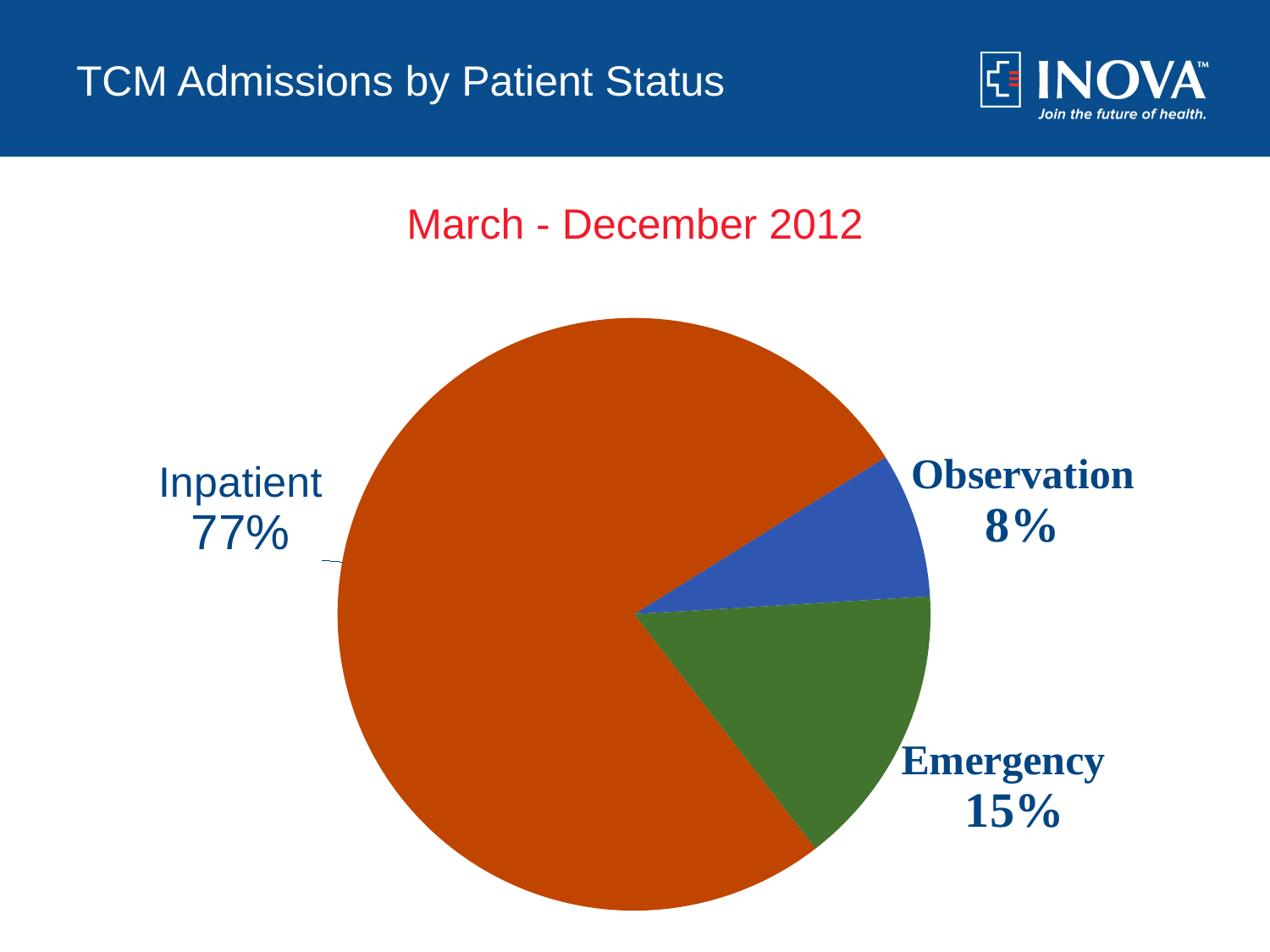
What is the difference in percentage points between the Emergency and Observation shares? 7 What share of TCM admissions is Emergency? 15% How many slices does the pie chart have? 3 What is the difference in percentage points between the Inpatient and Emergency shares? 62 Which patient status has the largest share of admissions? Inpatient What time period does the chart cover? March - December 2012 What share of TCM admissions is Inpatient? 77% What kind of chart is shown on the slide? pie chart Which patient status has the smallest share of admissions? Observation What colour is the Inpatient slice? orange What share of TCM admissions is Observation? 8% Which is larger, the Emergency share or the Observation share? Emergency